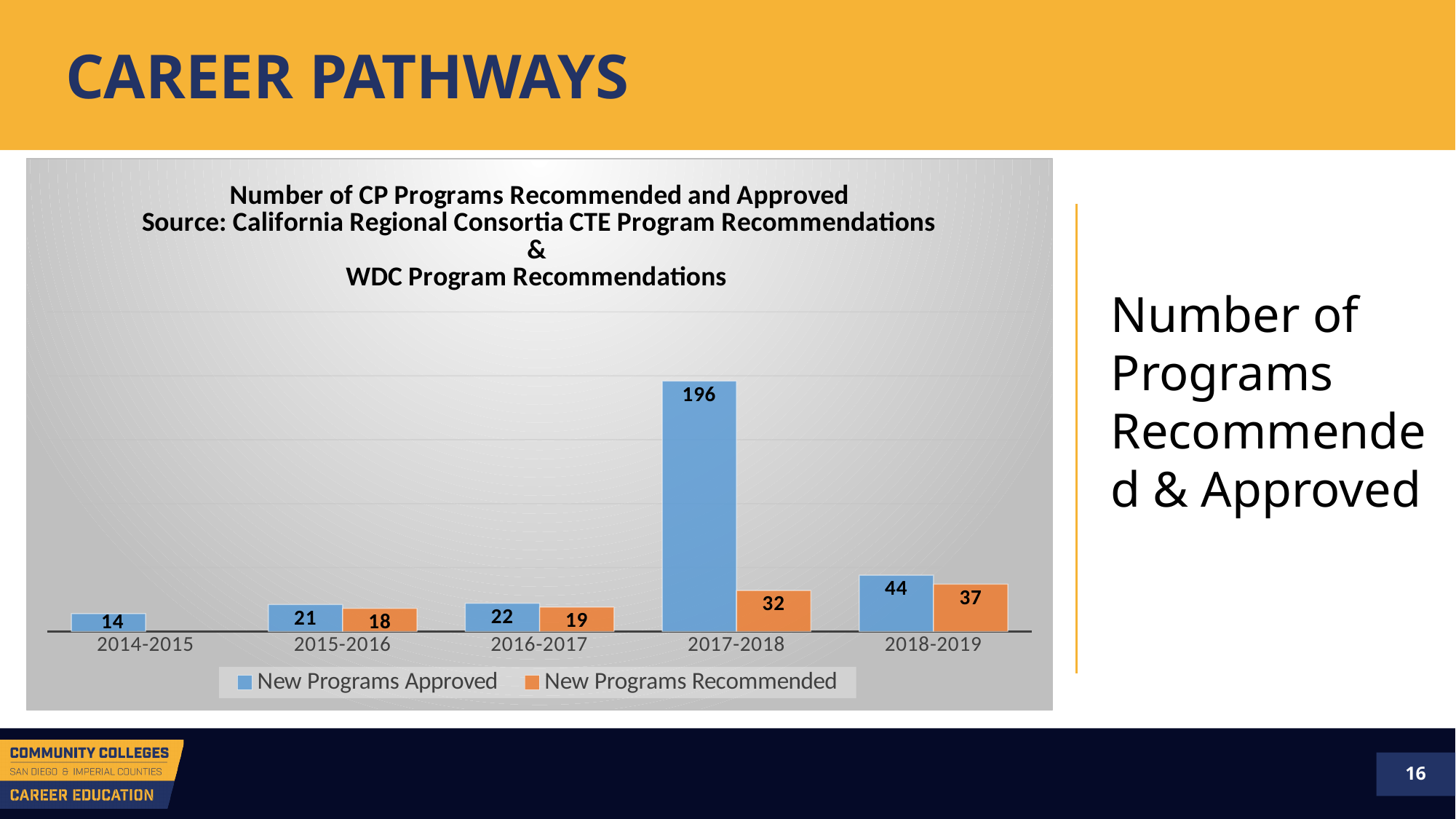
How many series does the legend list? 2 What is the difference between New Programs Approved and New Programs Recommended in 2017-2018? 164 What is the value for New Programs Approved in 2014-2015? 14 What is the value for New Programs Approved in 2017-2018? 196 What is the value for New Programs Recommended in 2016-2017? 19 Which is larger in 2018-2019: New Programs Approved or New Programs Recommended? New Programs Approved Which year has the lowest value for New Programs Recommended among those shown? 2015-2016 How many year categories are shown on the x axis? 5 What kind of chart is shown on the slide? Bar chart Which colour represents New Programs Recommended in the chart? Orange Which year has the highest value for New Programs Approved? 2017-2018 What is the value for New Programs Recommended in 2018-2019? 37